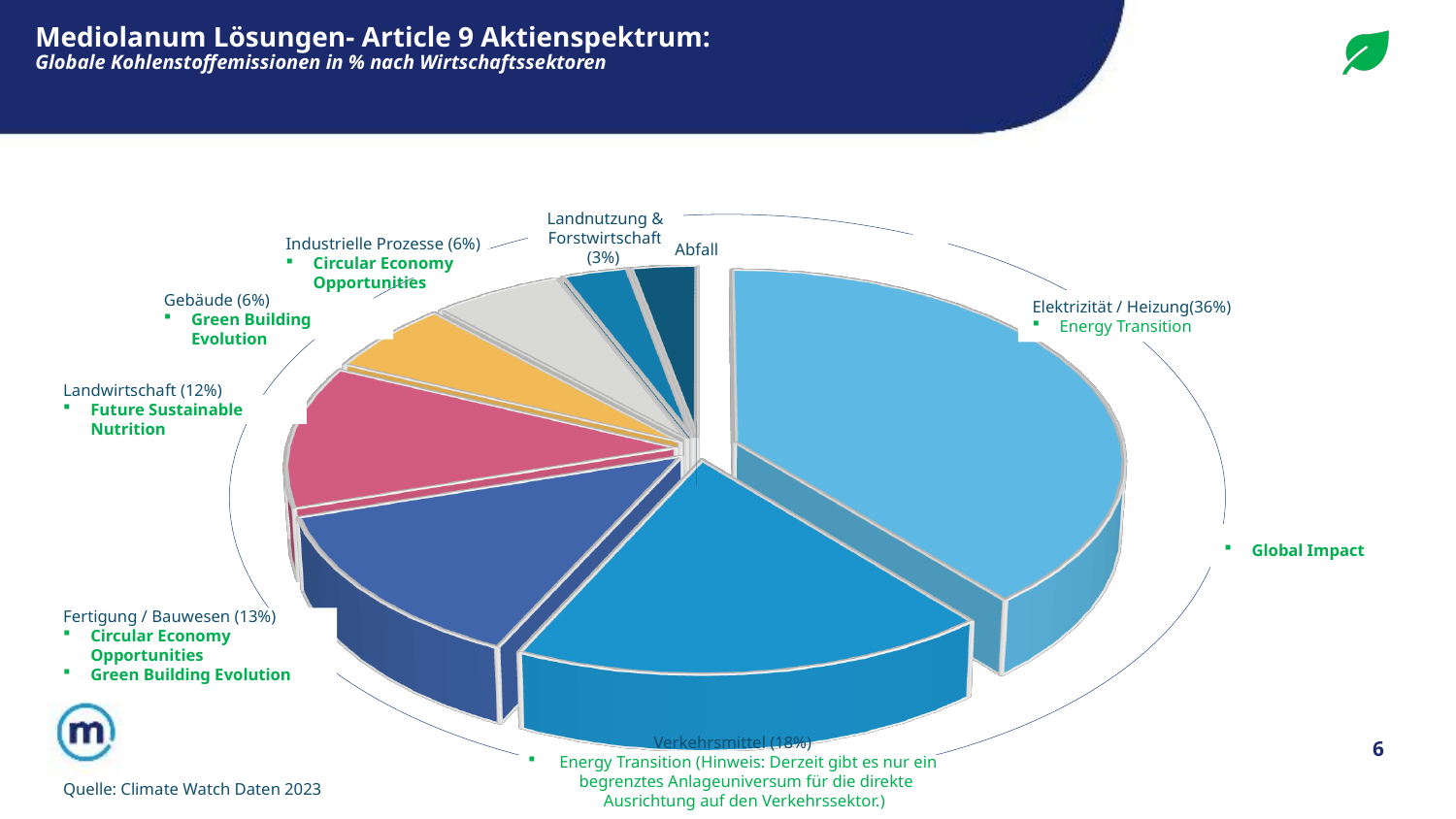
Which sector has the largest share of the pie? Elektrizität / Heizung What percentage is shown for Verkehrsmittel? 18% What share of global carbon emissions is attributed to Elektrizität / Heizung? 36% What is the subtitle of the chart on the slide? Globale Kohlenstoffemissionen in % nach Wirtschaftssektoren What type of chart is shown on the slide? Pie chart What percentage is shown for Fertigung / Bauwesen? 13% How many sectors (slices) are shown in the pie chart? 8 What data source is cited for the chart? Climate Watch Daten 2023 What percentage is shown for Landnutzung & Forstwirtschaft? 3% What percentage is shown for Landwirtschaft? 12% How many percentage points larger is the share of Elektrizität / Heizung than that of Verkehrsmittel? 18 Which has the larger share, Fertigung / Bauwesen or Landwirtschaft? Fertigung / Bauwesen